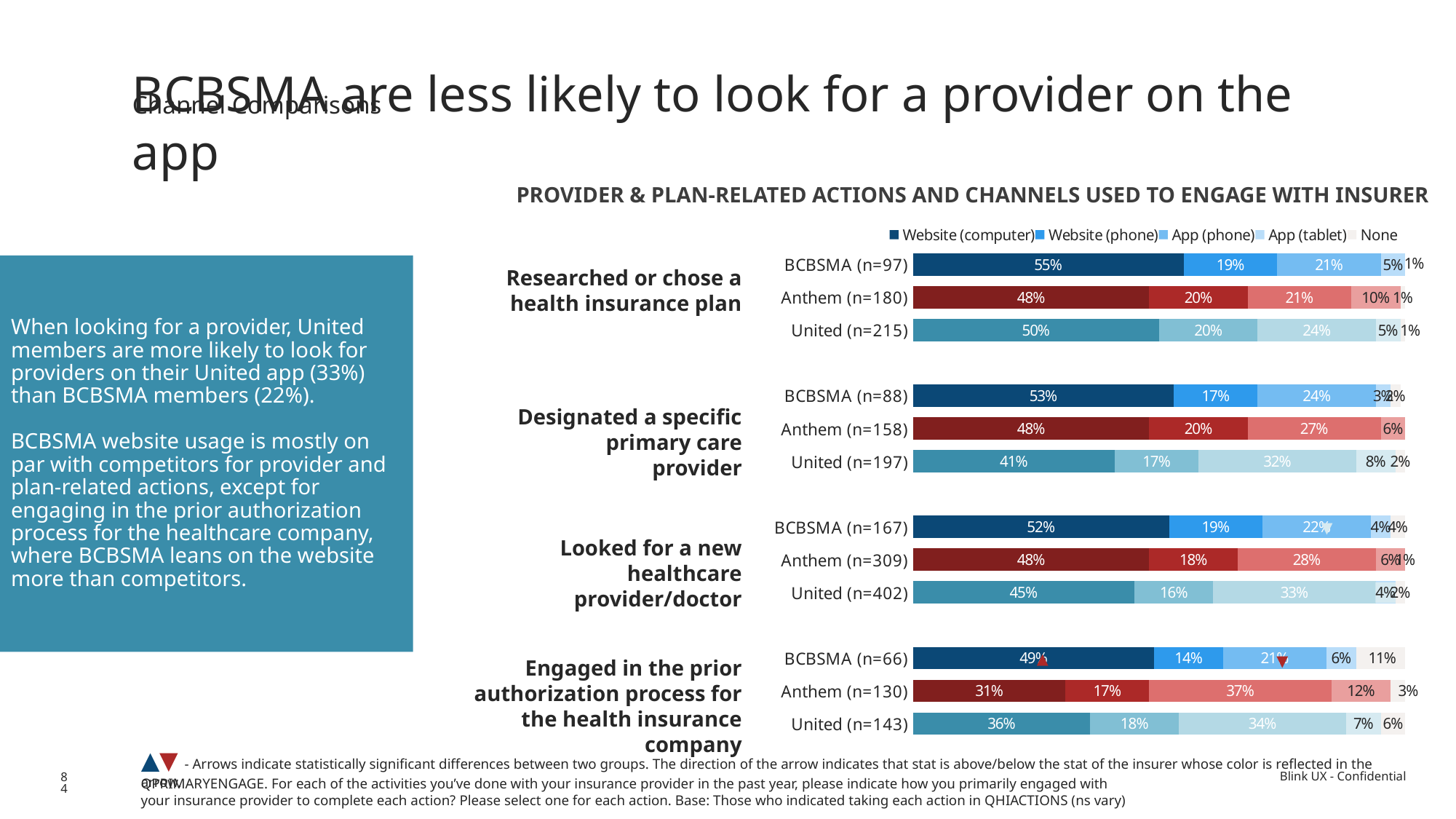
Which insurer has the lowest Website (computer) share for 'Engaged in the prior authorization process for the health insurance company'? Anthem (n=130) What is the Website (computer) value for BCBSMA (n=97) under 'Researched or chose a health insurance plan'? 55% What is the title of the chart? PROVIDER & PLAN-RELATED ACTIONS AND CHANNELS USED TO ENGAGE WITH INSURER How many bars are plotted in the chart in total? 12 What is the App (phone) value for United (n=402) under 'Looked for a new healthcare provider/doctor'? 33% How many series does the chart legend list? 5 What is the difference between the App (phone) values for United (n=402) and BCBSMA (n=167) under 'Looked for a new healthcare provider/doctor'? 11 percentage points What is the Website (computer) value for Anthem (n=130) under 'Engaged in the prior authorization process for the health insurance company'? 31% What is the None value for BCBSMA (n=66) under 'Engaged in the prior authorization process for the health insurance company'? 11% Under 'Designated a specific primary care provider', which is larger: the App (phone) value for United (n=197) or for Anthem (n=158)? United (n=197) Which insurer has the highest Website (computer) share for 'Designated a specific primary care provider'? BCBSMA (n=88) What kind of chart is shown on the slide? Stacked bar chart